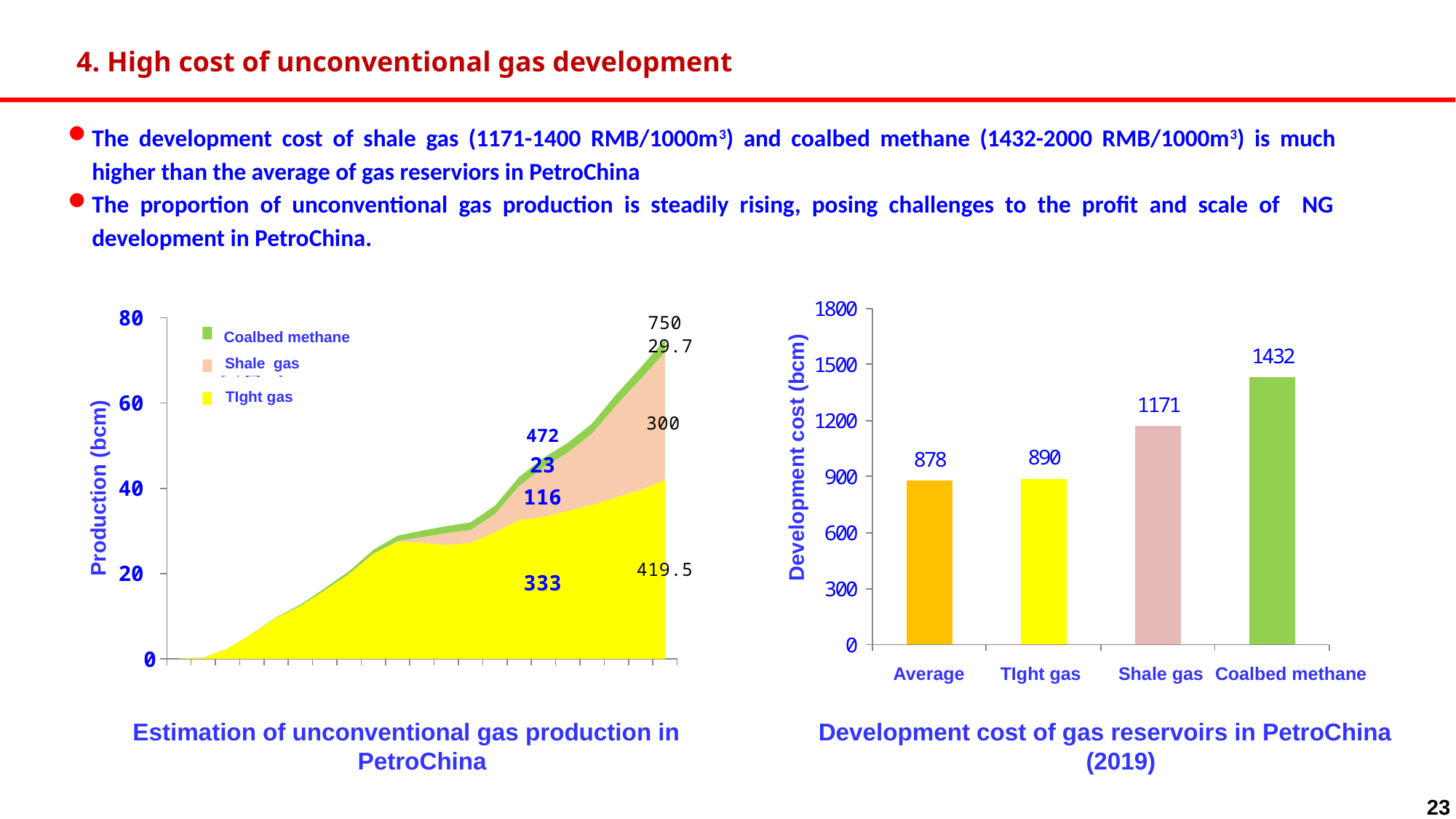
What kind of chart is the one titled 'Development cost of gas reservoirs in PetroChina (2019)'? bar chart In the chart titled 'Development cost of gas reservoirs in PetroChina (2019)', how many categories are shown on the x axis? 4 In the chart titled 'Development cost of gas reservoirs in PetroChina (2019)', which category has the lowest development cost? Average In the chart titled 'Development cost of gas reservoirs in PetroChina (2019)', what is the development cost for Shale gas? 1171 In the chart titled 'Development cost of gas reservoirs in PetroChina (2019)', what is the difference between the Tight gas and Average values? 12 In the chart titled 'Development cost of gas reservoirs in PetroChina (2019)', what is the difference between the Coalbed methane and Shale gas values? 261 In the chart titled 'Estimation of unconventional gas production in PetroChina', which series is shown in yellow? Tight gas In the chart titled 'Development cost of gas reservoirs in PetroChina (2019)', what is the value for Average? 878 In the chart titled 'Development cost of gas reservoirs in PetroChina (2019)', which category has the highest development cost? Coalbed methane In the chart titled 'Development cost of gas reservoirs in PetroChina (2019)', is the value for Shale gas greater or less than 1200? less In the chart titled 'Development cost of gas reservoirs in PetroChina (2019)', what is the development cost for Coalbed methane? 1432 In the chart titled 'Estimation of unconventional gas production in PetroChina', how many series does the legend list? 3